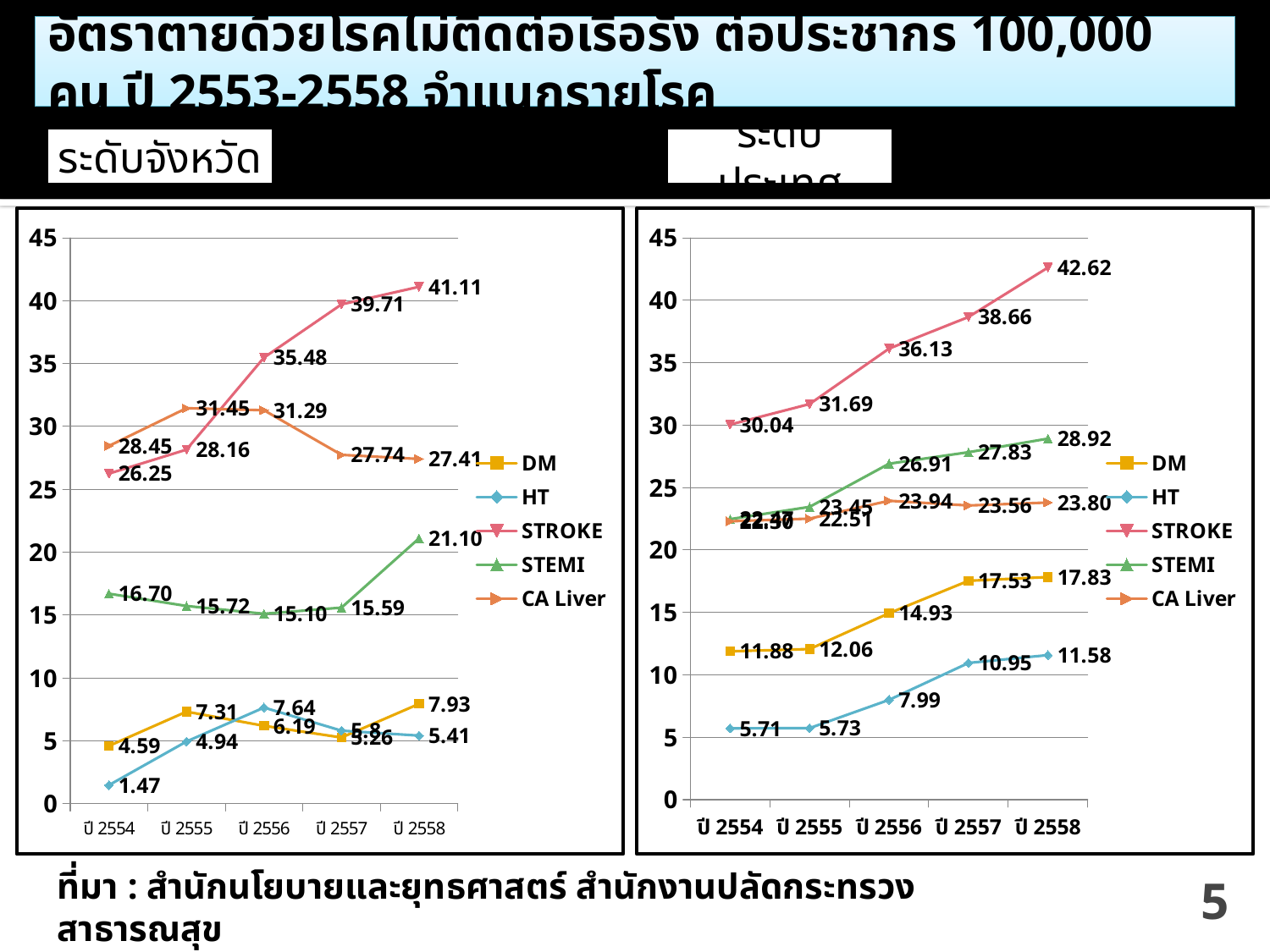
In the left chart, which series has the highest value in ปี 2558? STROKE In the left chart, which is larger in ปี 2554: the CA Liver value or the STROKE value? CA Liver In the right chart, what is the difference between the STROKE values for ปี 2558 and ปี 2554? 12.58 In the left chart, what is the CA Liver value for ปี 2555? 31.45 What type of chart is the left chart? Line chart In the right chart, what is the HT value for ปี 2554? 5.71 In the right chart, which series has the lowest value in ปี 2554? HT In the right chart, what is the DM value for ปี 2556? 14.93 In the left chart, what is the STROKE value for ปี 2558? 41.11 In the right chart, does the STROKE series rise or fall from ปี 2554 to ปี 2558? Rise In the right chart, what is the STROKE value for ปี 2558? 42.62 How many series does the legend of the right chart list? 5